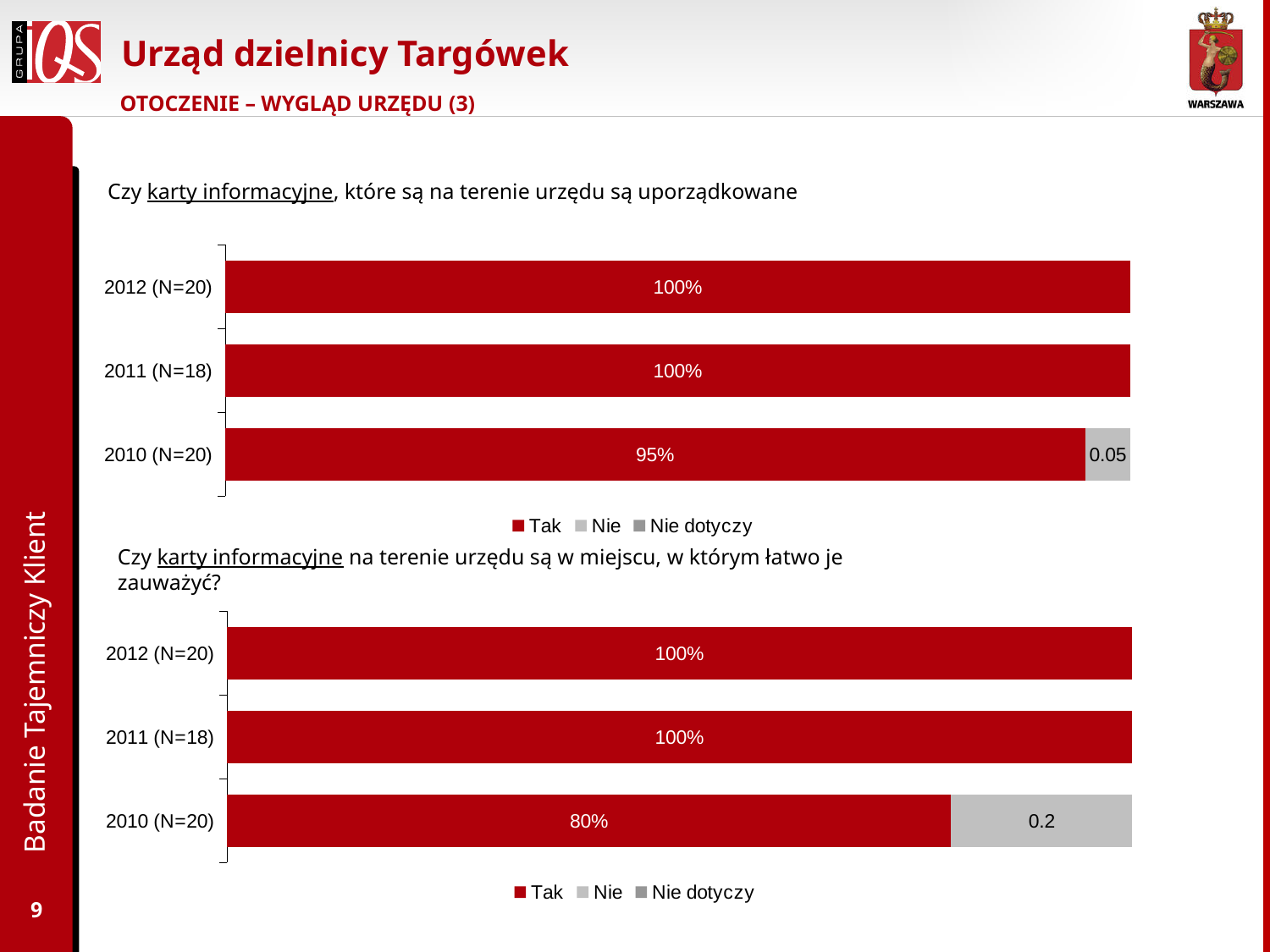
In the top chart, which year has the lowest 'Tak' value? 2010 (N=20) In the bottom chart, which year has the lowest 'Tak' value? 2010 (N=20) What type of chart is the top chart? Stacked bar chart In the top chart, what is the 'Tak' value for 2011 (N=18)? 100% In the bottom chart, what is the 'Tak' value for 2012 (N=20)? 100% How many year categories are shown in the bottom chart? 3 In the bottom chart, what is the difference between the 'Tak' value for 2012 (N=20) and the 'Tak' value for 2010 (N=20)? 20% In the top chart, what is the 'Nie' value shown for 2010 (N=20)? 0.05 In the bottom chart, what is the 'Nie' value shown for 2010 (N=20)? 0.2 In the bottom chart, what is the 'Tak' value for 2010 (N=20)? 80% How many series does the legend of the top chart list? 3 In the top chart, what is the 'Tak' value for 2010 (N=20)? 95%